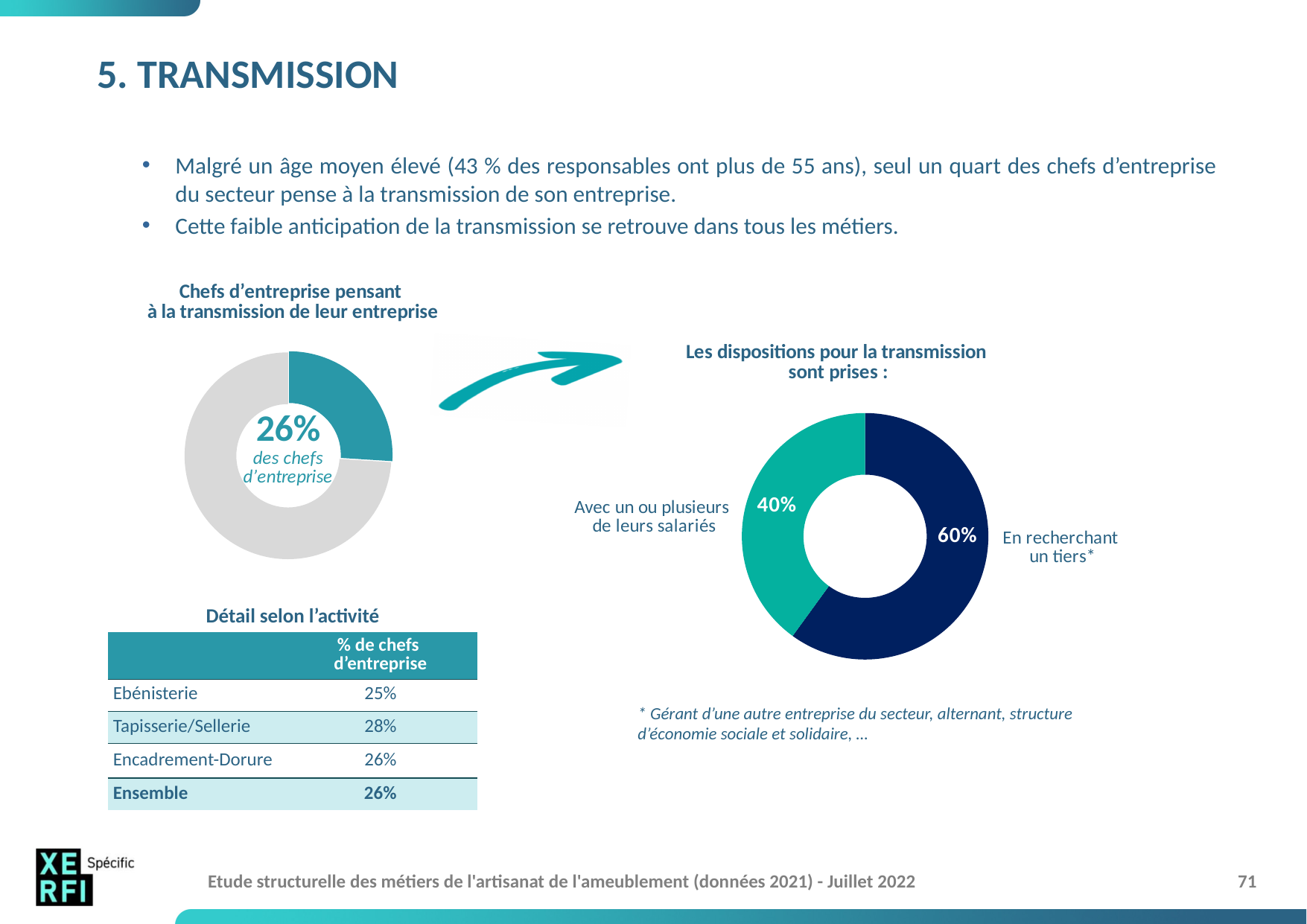
What kind of chart is 'Chefs d'entreprise pensant à la transmission de leur entreprise'? Donut (pie) chart In the chart 'Les dispositions pour la transmission sont prises :', which category has the smallest share? Avec un ou plusieurs de leurs salariés In the chart 'Chefs d'entreprise pensant à la transmission de leur entreprise', what share of business owners are thinking about the transmission of their company? 26% In the chart 'Les dispositions pour la transmission sont prises :', which category has the largest share? En recherchant un tiers* In the chart 'Les dispositions pour la transmission sont prises :', what is the value for 'Avec un ou plusieurs de leurs salariés'? 40% In the chart 'Chefs d'entreprise pensant à la transmission de leur entreprise', is the highlighted share greater or less than 50%? less How many slices does the chart 'Les dispositions pour la transmission sont prises :' have? 2 In the chart 'Les dispositions pour la transmission sont prises :', what is the difference in percentage points between 'En recherchant un tiers*' and 'Avec un ou plusieurs de leurs salariés'? 20 percentage points In the chart 'Les dispositions pour la transmission sont prises :', which is larger: 'Avec un ou plusieurs de leurs salariés' or 'En recherchant un tiers*'? En recherchant un tiers* In the chart 'Les dispositions pour la transmission sont prises :', what is the value for 'En recherchant un tiers*'? 60% In the chart 'Les dispositions pour la transmission sont prises :', what colour is the slice for 'En recherchant un tiers*'? Dark navy blue What kind of chart is 'Les dispositions pour la transmission sont prises :'? Donut (pie) chart